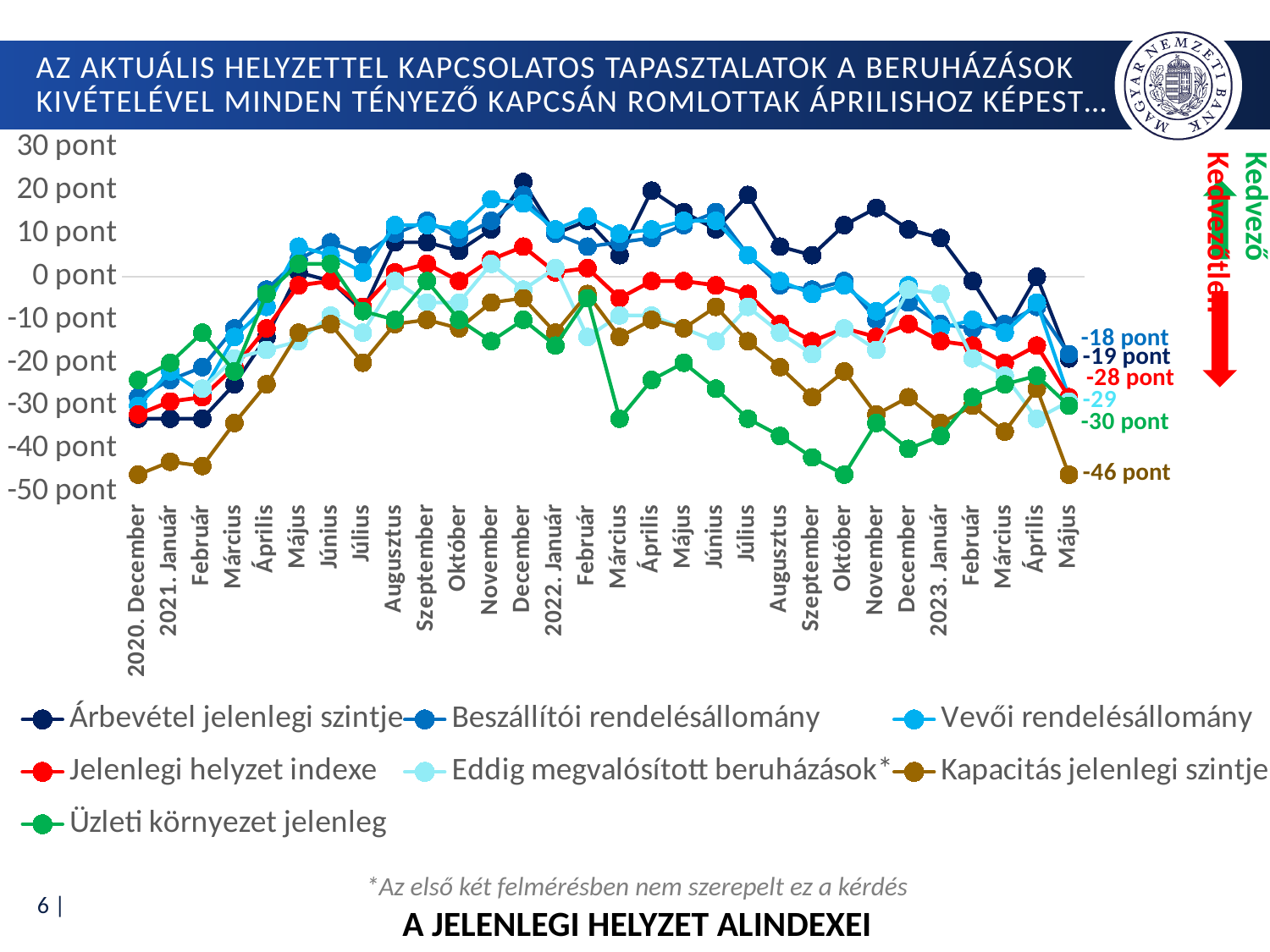
What is the final (2023 Május) value labelled for Kapacitás jelenlegi szintje? -46 pont Is the value for Kapacitás jelenlegi szintje in 2020. December greater or less than -40 pont? less What is the final (2023 Május) value labelled for Üzleti környezet jelenleg? -30 pont What is the final (2023 Május) value labelled for Jelenlegi helyzet indexe? -28 pont What is the difference between the final values of Beszállítói rendelésállomány (-18 pont) and Kapacitás jelenlegi szintje (-46 pont)? 28 pont How many series does the legend list? 7 What is the title printed below the chart? A JELENLEGI HELYZET ALINDEXEI How many time points are shown on the x axis? 30 What is the final (2023 Május) value labelled for Beszállítói rendelésállomány? -18 pont What kind of chart is shown on the slide? line chart What is the final (2023 Május) value labelled for Árbevétel jelenlegi szintje? -19 pont Which series has the lowest value at the last point (2023 Május)? Kapacitás jelenlegi szintje